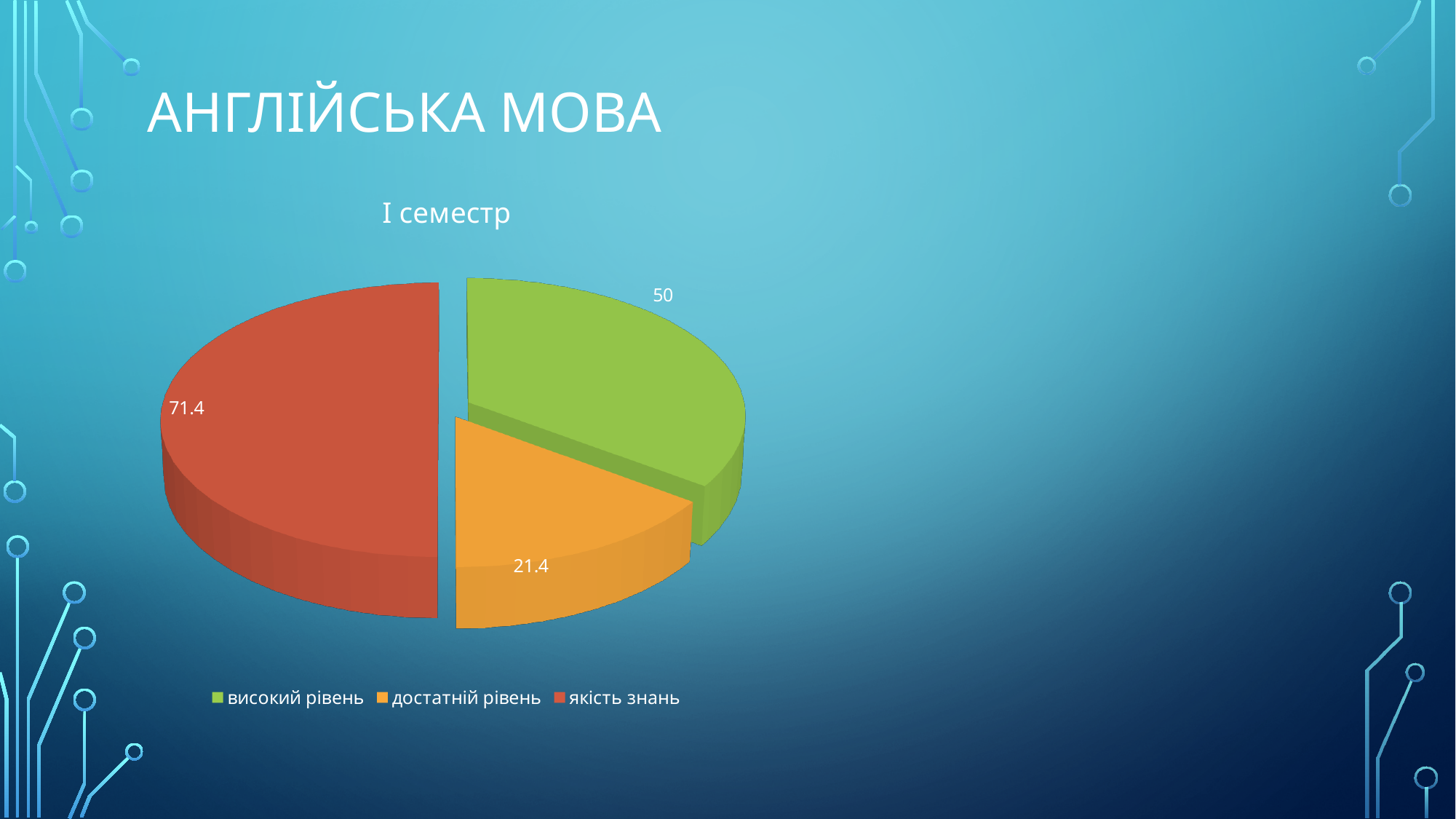
What is the difference between the values for якість знань and високий рівень? 21.4 What is the value for високий рівень? 50 What colour is the slice for якість знань? red How many slices does the pie chart have? 3 What type of chart is shown on the slide? pie chart What is the title of the chart? І семестр What is the value for достатній рівень? 21.4 What is the value for якість знань? 71.4 Which category has the smallest slice? достатній рівень Which category has the largest slice? якість знань What is the difference between the values for високий рівень and достатній рівень? 28.6 Which is larger, the value for високий рівень or the value for достатній рівень? високий рівень